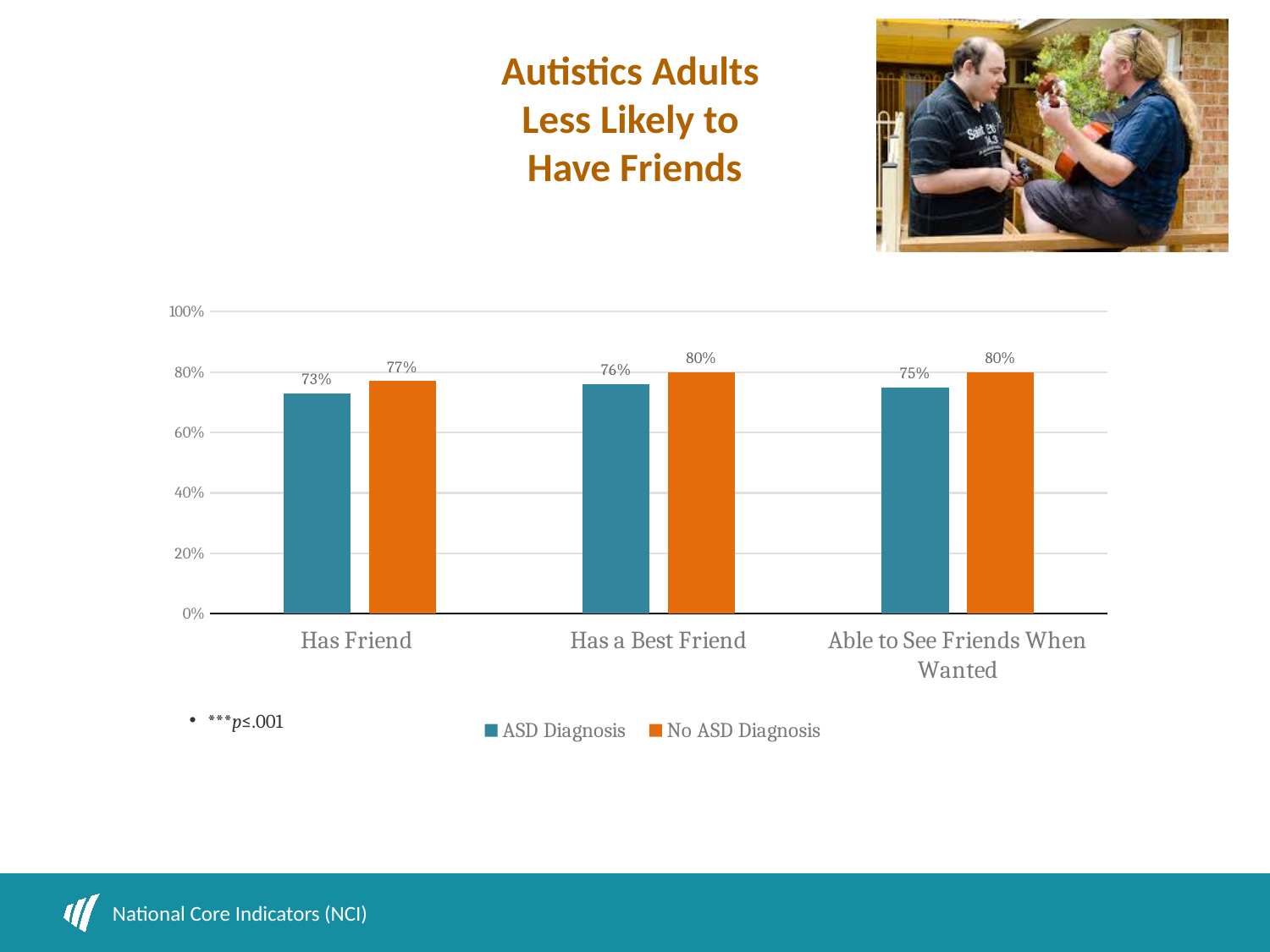
What is the difference between No ASD Diagnosis and ASD Diagnosis in the Has Friend category? 4% What colour are the No ASD Diagnosis bars? orange What is the difference between No ASD Diagnosis and ASD Diagnosis in the Able to See Friends When Wanted category? 5% In the Has a Best Friend category, which series has the larger value, ASD Diagnosis or No ASD Diagnosis? No ASD Diagnosis What kind of chart is shown on the slide? bar chart What is the value for ASD Diagnosis in the Has Friend category? 73% How many categories are shown on the x axis? 3 Which category has the lowest value for ASD Diagnosis? Has Friend What is the value for ASD Diagnosis in the Able to See Friends When Wanted category? 75% What is the value for No ASD Diagnosis in the Has a Best Friend category? 80% How many series does the legend list? 2 Is the value for ASD Diagnosis in the Has Friend category greater or less than 80%? less